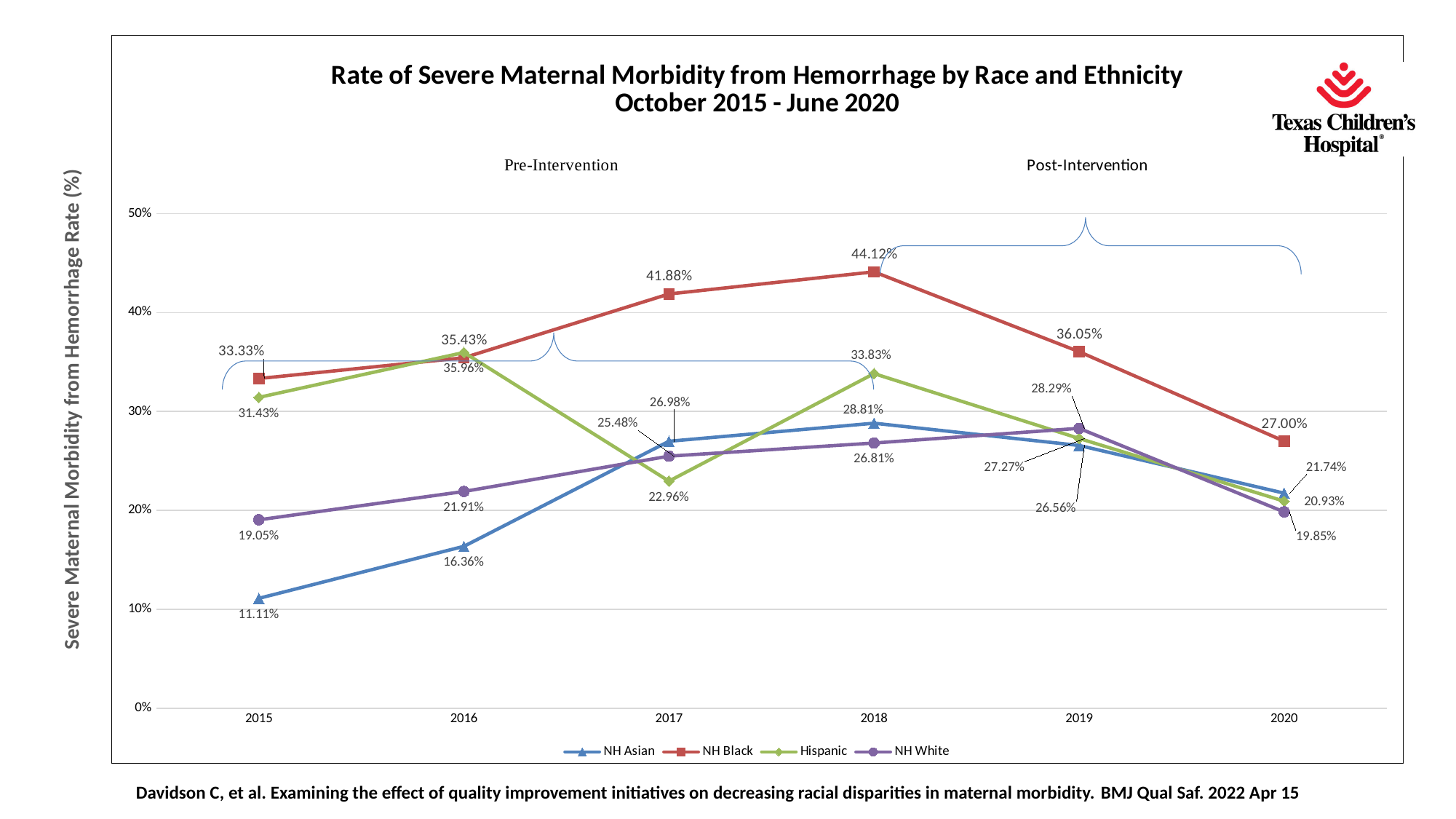
Did the NH Asian rate rise or fall from 2015 to 2018? Rise Which group had the lowest rate in 2015? NH Asian What was the NH Asian rate in 2015? 11.11% What is the difference between the NH Black rate in 2018 and in 2020? 17.12% What was the Hispanic rate in 2017? 22.96% What was the NH White rate in 2020? 19.85% In which year was the NH Black rate highest? 2018 Which was higher in 2016, the NH Black rate or the Hispanic rate? Hispanic How many years are shown on the x axis? 6 What was the NH Black rate in 2018? 44.12% How many series does the legend list? 4 What kind of chart is this? Line chart